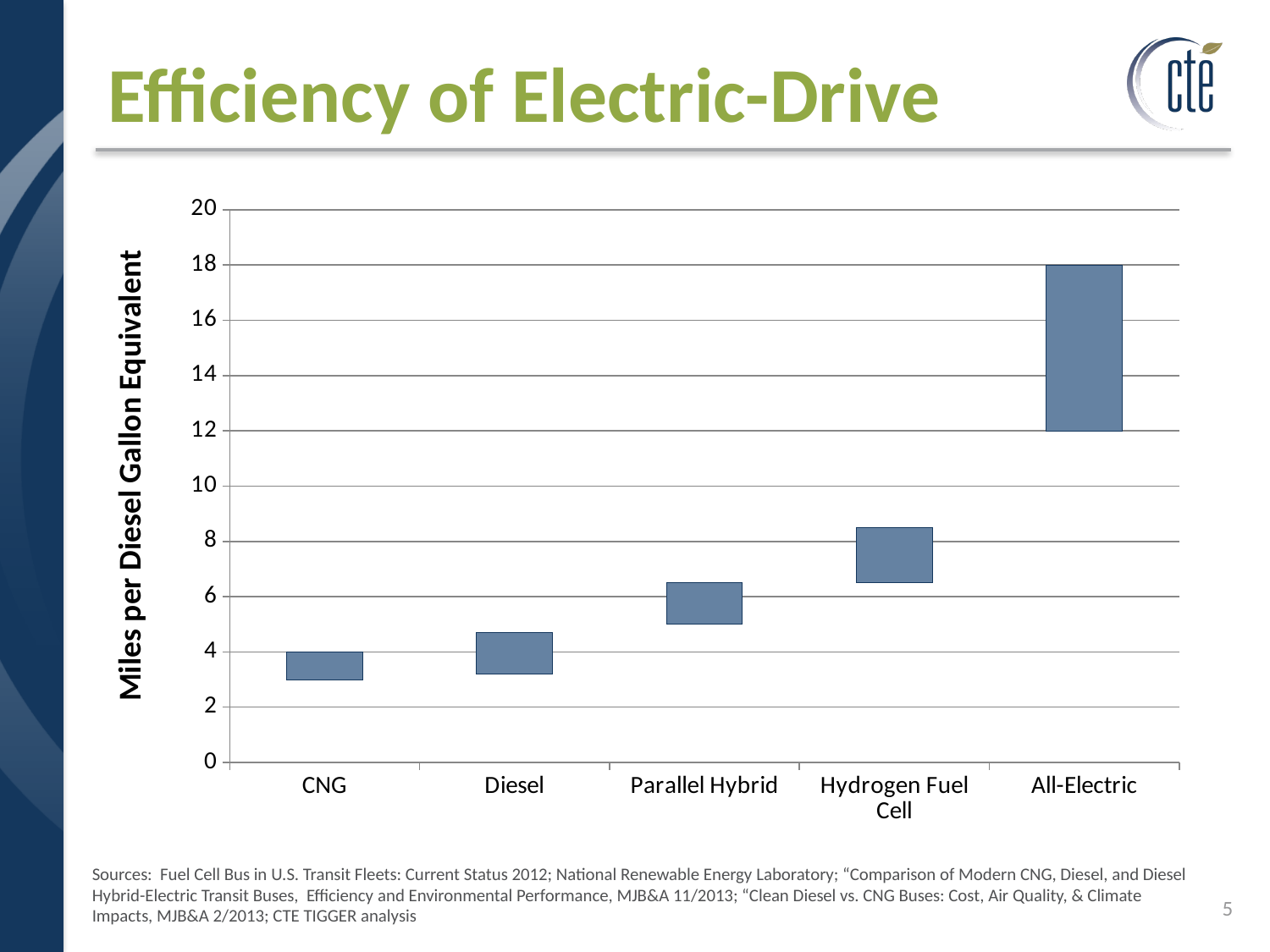
Which bus type has the highest miles per diesel gallon equivalent? All-Electric Which has a higher miles per diesel gallon equivalent, Diesel or Parallel Hybrid? Parallel Hybrid What is the upper end of the range shown for All-Electric? 18 Do the values rise or fall moving from CNG to All-Electric along the x axis? rise Is the value for Hydrogen Fuel Cell greater or less than 10? less Which has a higher miles per diesel gallon equivalent, Hydrogen Fuel Cell or All-Electric? All-Electric How many bus types (categories) are shown on the x axis? 5 What kind of chart is shown on the slide? bar chart Is the value for All-Electric greater or less than 10? greater Is the value for CNG greater or less than 6? less Which bus type has the lowest miles per diesel gallon equivalent? CNG What is the label on the y axis? Miles per Diesel Gallon Equivalent